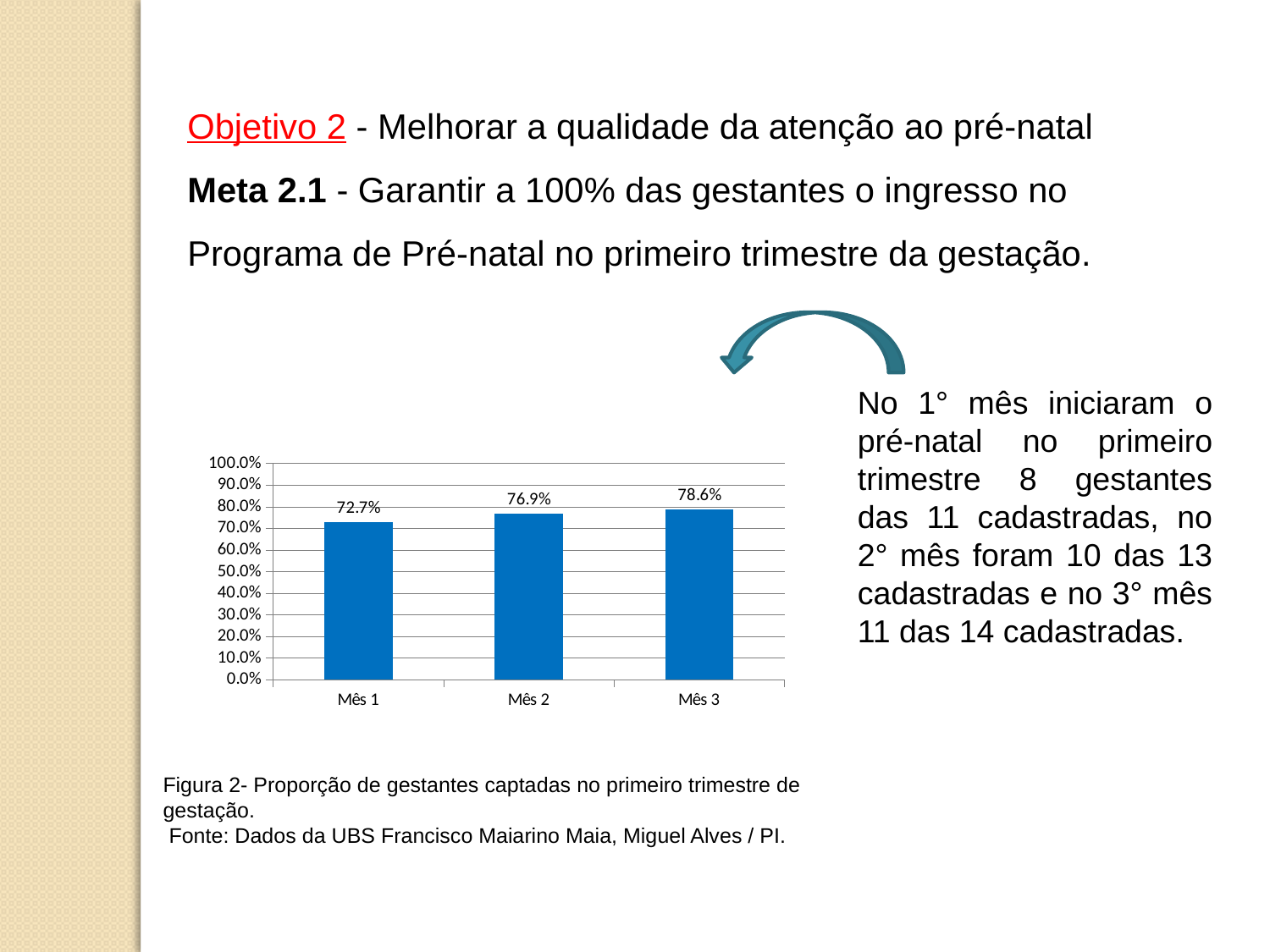
Which month has the highest value? Mês 3 Which is larger, the value for Mês 1 or the value for Mês 2? Mês 2 Is the value for Mês 3 greater or less than 80.0%? less Do the values rise or fall from Mês 1 to Mês 3? rise What is the value for Mês 2? 76.9% How many months are shown on the x axis? 3 What is the difference between the values for Mês 3 and Mês 1? 5.9% What is the difference between the values for Mês 2 and Mês 1? 4.2% What kind of chart is shown on the slide? bar chart What is the value for Mês 1? 72.7% What is the value for Mês 3? 78.6% Which month has the lowest value? Mês 1